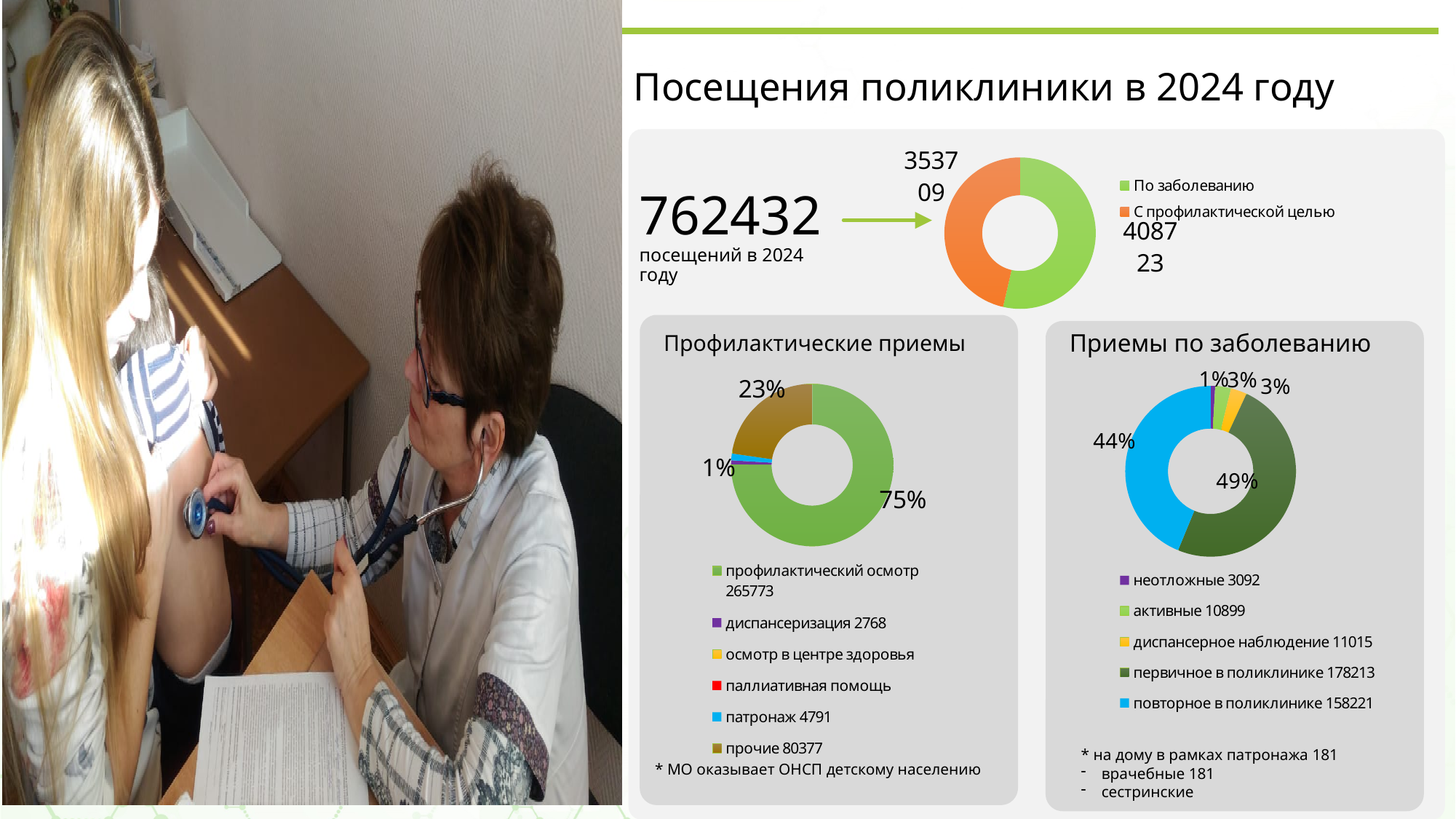
In the "Приемы по заболеванию" chart, what is the value for "первичное в поликлинике"? 178213 In the "Профилактические приемы" chart, what share of the pie does "профилактический осмотр" take? 75% In the "Профилактические приемы" chart, what is the value for "прочие"? 80377 How many categories does the legend of the "Приемы по заболеванию" chart list? 5 In the "Приемы по заболеванию" chart, which category has the highest value? первичное в поликлинике What kind of chart is the "Приемы по заболеванию" chart? doughnut chart In the "Приемы по заболеванию" chart, which category has the lowest value? неотложные In the "Приемы по заболеванию" chart, what is the difference between "первичное в поликлинике" and "повторное в поликлинике"? 19992 How many categories does the legend of the "Профилактические приемы" chart list? 6 In the "Профилактические приемы" chart, what is the value for "профилактический осмотр"? 265773 In the top chart next to the total of 762432 visits, which segment is larger: "По заболеванию" or "С профилактической целью"? По заболеванию In the "Приемы по заболеванию" chart, what is the value for "повторное в поликлинике"? 158221